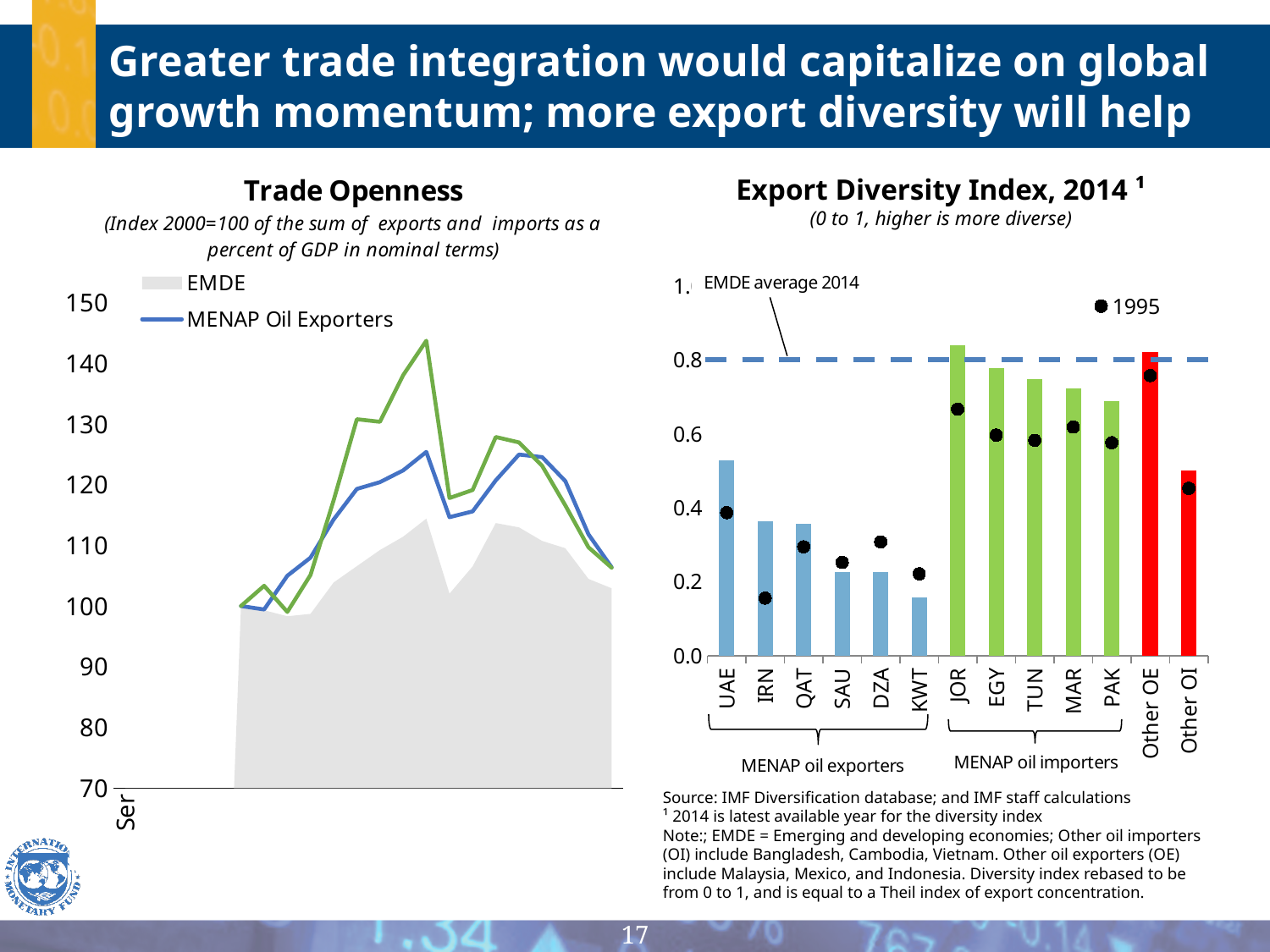
In the Export Diversity Index, 2014 chart, how many countries or groups are shown on the x axis? 13 In the Export Diversity Index, 2014 chart, is the 2014 value for PAK greater or less than 0.8? less In the Export Diversity Index, 2014 chart, is the 2014 value for SAU greater or less than 0.4? less In the Export Diversity Index, 2014 chart, what does the horizontal dashed line represent? EMDE average 2014 In the Export Diversity Index, 2014 chart, which category has the lowest 2014 bar? KWT In the Export Diversity Index, 2014 chart, which of the MENAP oil exporters has the highest 2014 bar? UAE In the Export Diversity Index, 2014 chart, is the 2014 value for UAE greater or less than 0.4? greater In the Export Diversity Index, 2014 chart, what kind of chart is used to show the 2014 values? bar chart In the Trade Openness chart, how many series does the legend list? 2 In the Trade Openness chart, what is the highest value shown on the y axis? 150 In the Export Diversity Index, 2014 chart, which has the larger 2014 bar, EGY or PAK? EGY In the Export Diversity Index, 2014 chart, which has the larger 2014 bar, UAE or IRN? UAE